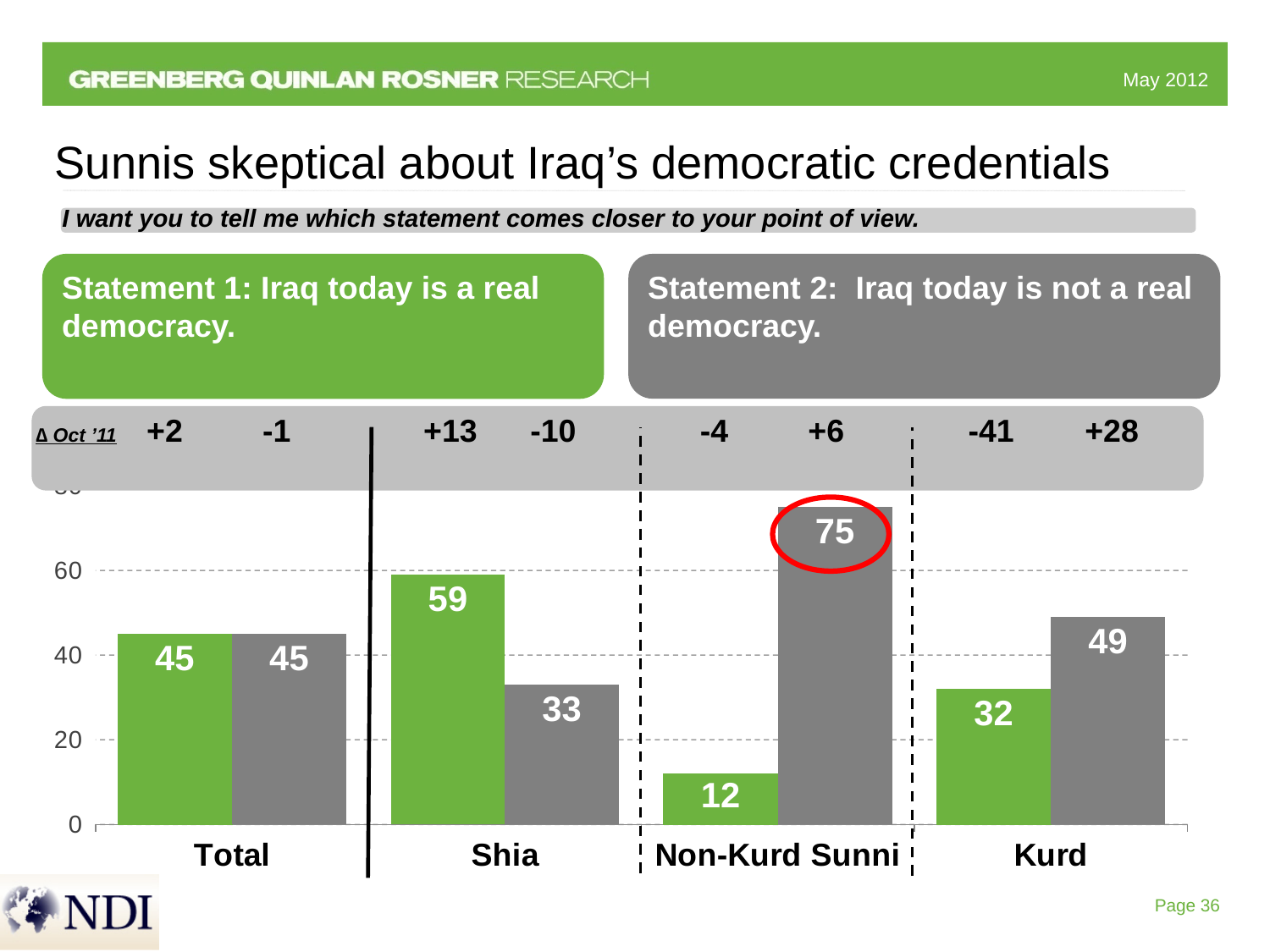
What is the value for Kurd for Statement 2 (Iraq today is not a real democracy)? 49 What kind of chart is shown on the slide? Bar chart Which group has the lowest value for Statement 1 (Iraq today is a real democracy)? Non-Kurd Sunni What is the difference between the Statement 2 and Statement 1 values for Non-Kurd Sunni? 63 What is the value for Shia for Statement 1 (Iraq today is a real democracy)? 59 What percentage of Non-Kurd Sunnis say Iraq today is not a real democracy (Statement 2)? 75 Which group has the highest value for Statement 2 (Iraq today is not a real democracy)? Non-Kurd Sunni Which colour represents Statement 1 (Iraq today is a real democracy) in the chart? Green For Shia, which is larger: the value for Statement 1 or the value for Statement 2? Statement 1 How many groups are shown on the x axis of the chart? 4 How many series (statements) are plotted in the chart? 2 Is the Statement 2 value for Kurd greater or less than 40? greater